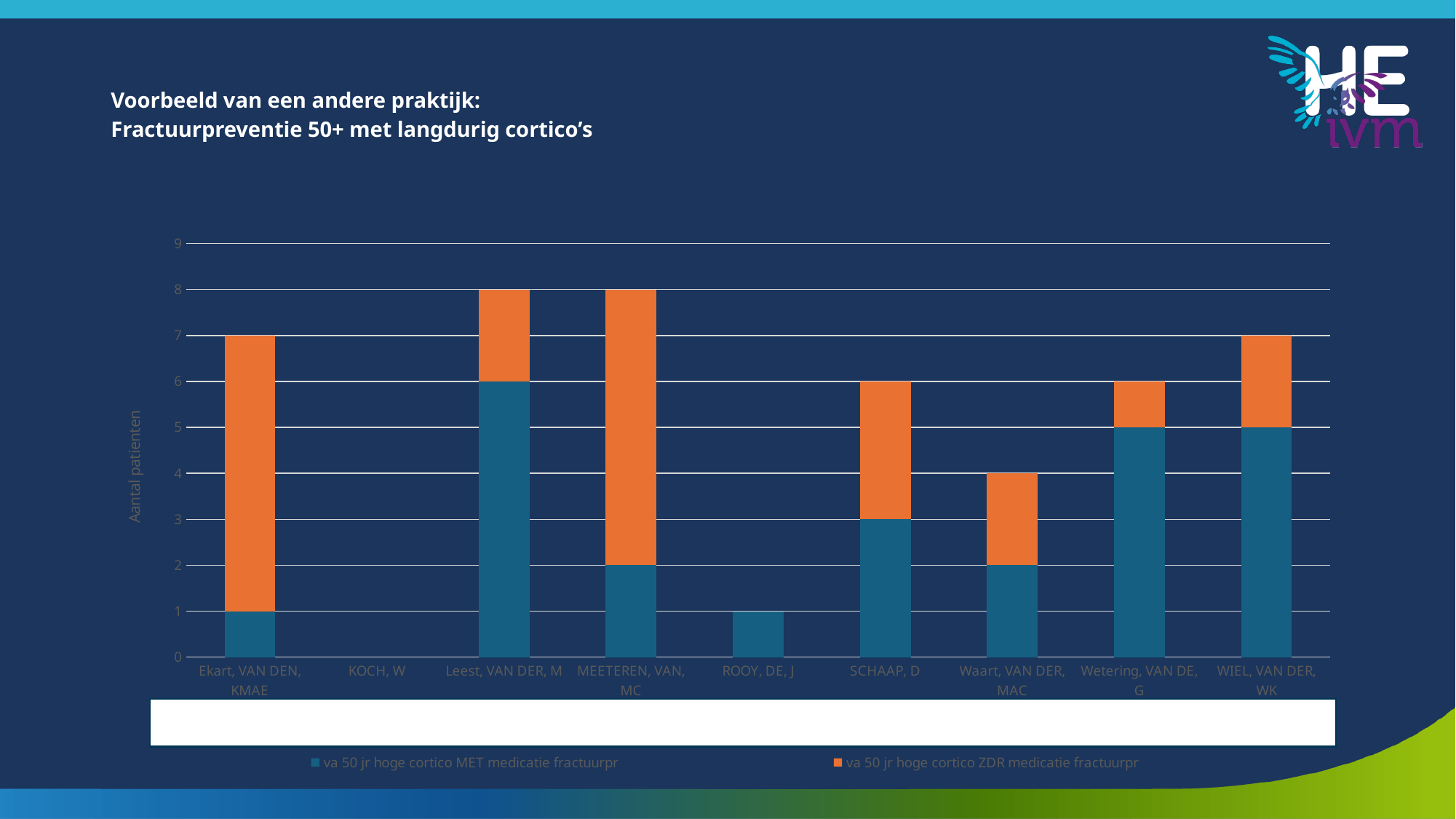
What is the value of 'va 50 jr hoge cortico MET medicatie fractuurpr' for Ekart, VAN DEN, KMAE? 1 Which is larger: the total for MEETEREN, VAN, MC or the total for WIEL, VAN DER, WK? MEETEREN, VAN, MC How many series does the legend list? 2 What is the total height of the stacked bar for Waart, VAN DER, MAC? 4 How many practitioner categories are shown on the x axis? 9 What is the label of the vertical axis? Aantal patienten What kind of chart is shown on the slide? Stacked bar chart What is the value of 'va 50 jr hoge cortico ZDR medicatie fractuurpr' for SCHAAP, D? 3 Which category has the lowest total, with no bar shown at all? KOCH, W What is the total height of the stacked bar for Leest, VAN DER, M? 8 What is the value of 'va 50 jr hoge cortico MET medicatie fractuurpr' for Wetering, VAN DE, G? 5 What is the difference between the total for Leest, VAN DER, M and the total for SCHAAP, D? 2